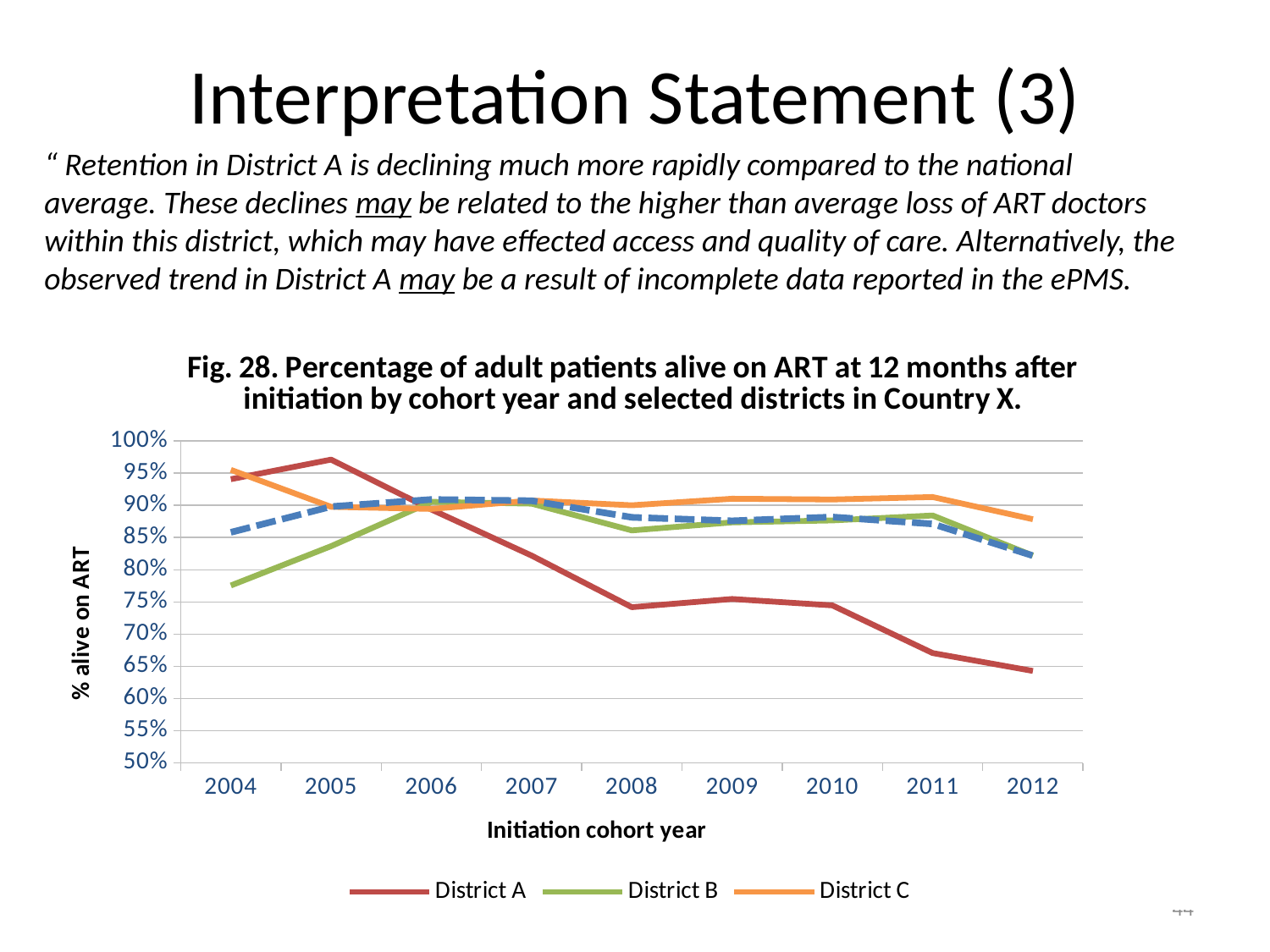
What is the title of the x axis in Fig. 28? Initiation cohort year How many initiation cohort years are shown on the x axis of Fig. 28? 9 Does the District A line rise or fall from 2005 to 2012? fall Which district has the highest value in 2008? District C Is the value for District A in 2012 greater or less than 70%? less Is the value for District A in 2008 greater or less than 80%? less Is the value for District A in 2005 greater or less than 95%? greater Which district has the lowest value in 2012? District A How many series does the legend of Fig. 28 list? 3 What kind of chart is Fig. 28? line chart In 2012, which is higher: District C or District A? District C